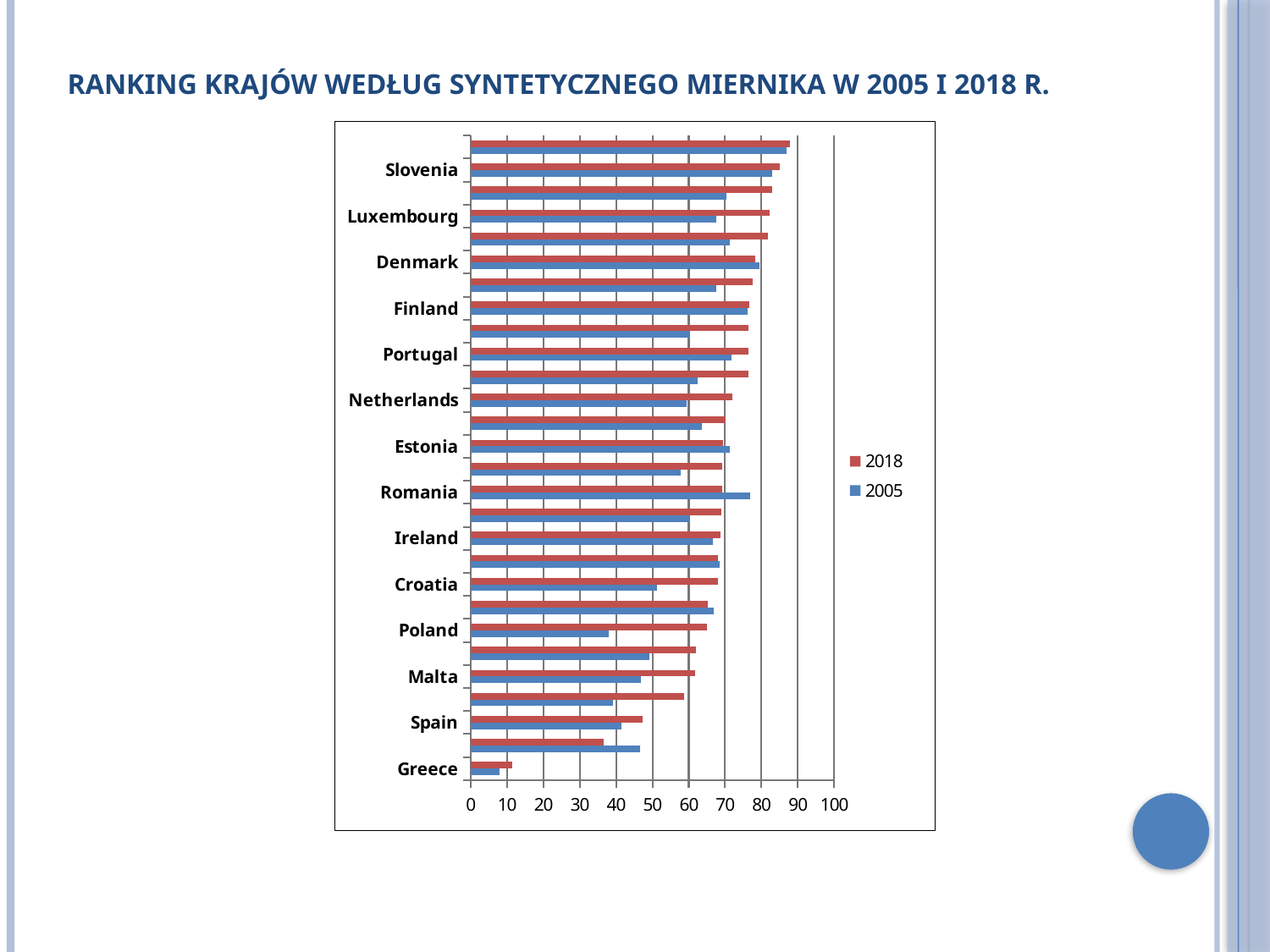
How many series does the legend list? 2 Is the 2018 value for Slovenia greater or less than 80? greater Which labelled country has the lowest value for 2018? Greece Do the 2018 values generally increase or decrease going from the top of the chart to the bottom? decrease Is the 2005 value for Malta greater or less than 50? less Which colour represents the 2005 series? blue For Poland, which year has the larger value, 2018 or 2005? 2018 Is the 2018 value for Greece greater or less than 20? less Which two years are listed in the legend? 2018 and 2005 What kind of chart is shown on the slide? bar chart For Romania, which year has the larger value, 2018 or 2005? 2005